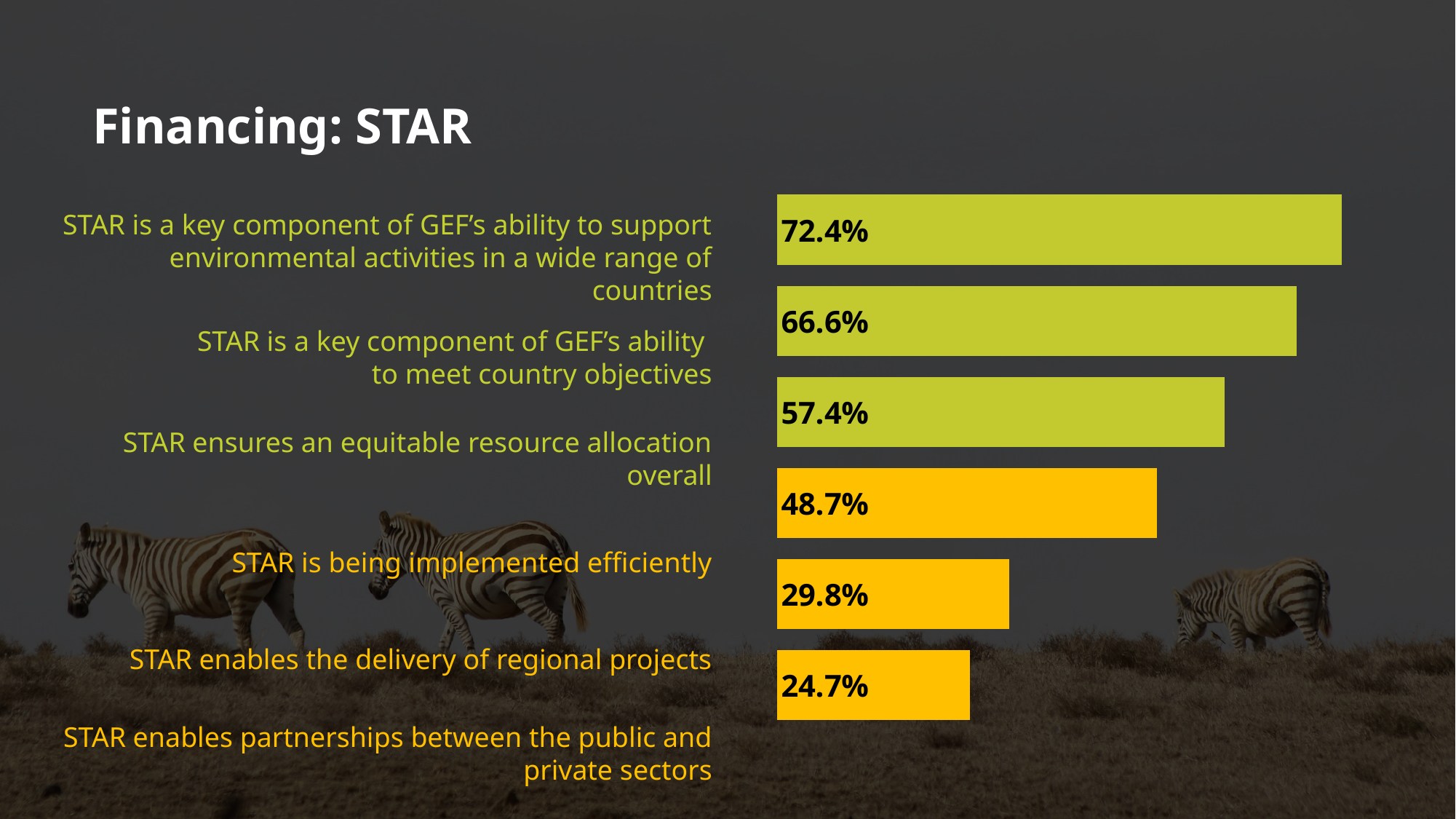
What percentage is shown for "STAR is a key component of GEF's ability to support environmental activities in a wide range of countries"? 72.4% How many bars are shown in the chart? 6 What percentage is shown for "STAR is being implemented efficiently"? 48.7% Which statement has the highest percentage? STAR is a key component of GEF's ability to support environmental activities in a wide range of countries What percentage is shown for "STAR enables the delivery of regional projects"? 29.8% Which statement has the lowest percentage? STAR enables partnerships between the public and private sectors What percentage is shown for "STAR ensures an equitable resource allocation overall"? 57.4% What percentage is shown for "STAR is a key component of GEF's ability to meet country objectives"? 66.6% Which is larger: the value for "STAR is being implemented efficiently" or the value for "STAR enables the delivery of regional projects"? STAR is being implemented efficiently What is the difference in percentage points between the highest bar (72.4%) and the lowest bar (24.7%)? 47.7 What type of chart is shown on the slide? Bar chart What percentage is shown for "STAR enables partnerships between the public and private sectors"? 24.7%